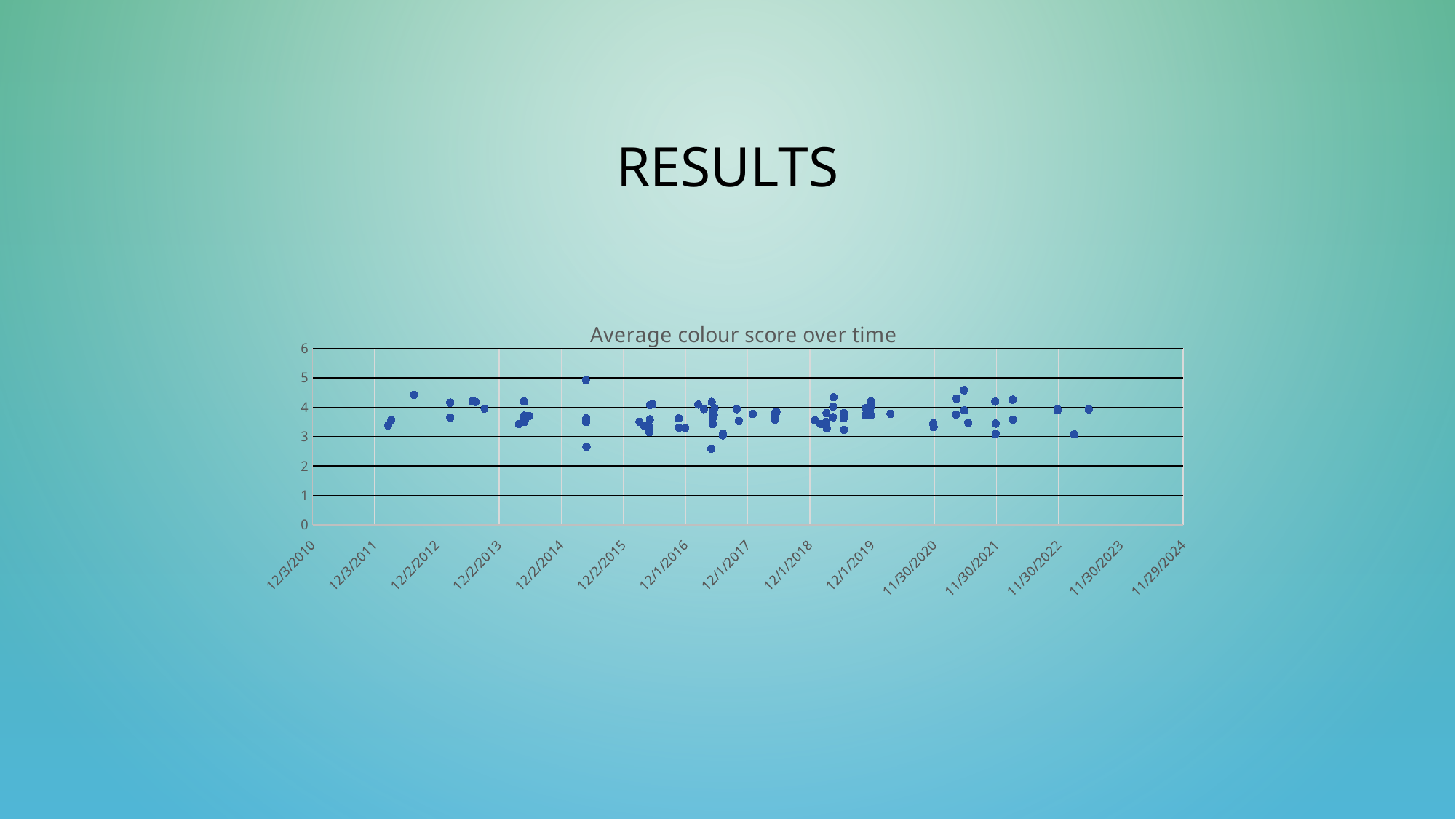
What is the first date label on the chart's horizontal axis? 12/3/2010 What is the highest value shown on the chart's vertical axis? 6 What is the title of the chart? Average colour score over time Is the lowest point plotted between 12/1/2016 and 12/1/2017 greater or less than 3? less Do the plotted scores show a clear rise or fall over time, or stay roughly level? Roughly level What is the last date label on the chart's horizontal axis? 11/29/2024 Is the highest plotted point on the chart greater or less than 4? greater How many date labels are shown on the chart's horizontal axis? 15 Are any points plotted after the 11/30/2023 tick on the horizontal axis? No What kind of chart is shown on the slide? Scatter chart Is the lowest plotted point on the chart greater or less than 3? less